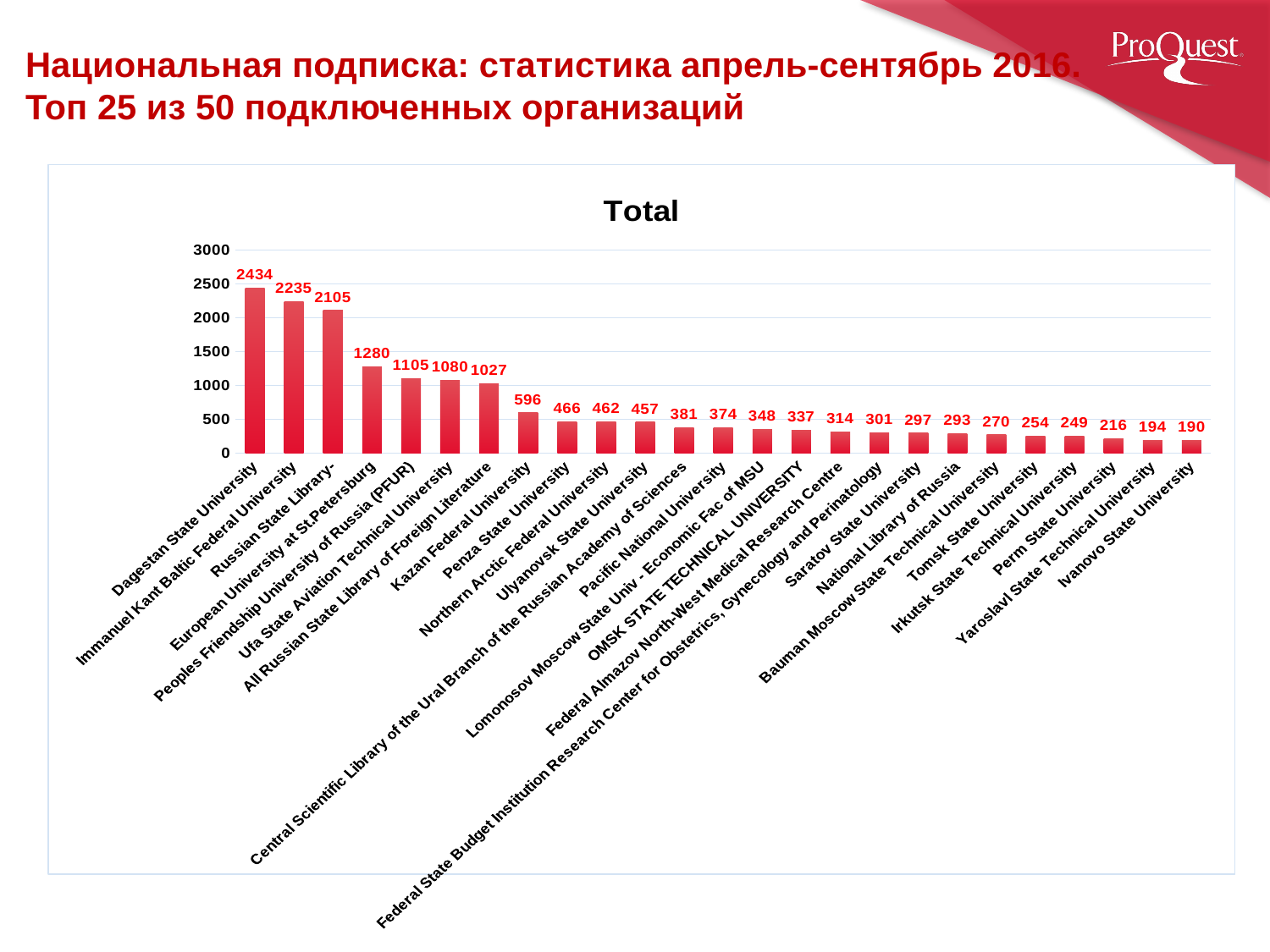
What is the value for Dagestan State University? 2434 What is the title of the chart? Total What kind of chart is shown on the slide? bar chart Which organization has the highest value? Dagestan State University What is the difference between the values for Dagestan State University and Immanuel Kant Baltic Federal University? 199 Which is larger, the value for Russian State Library or the value for European University at St.Petersburg? Russian State Library What is the value for Tomsk State University? 254 Is the value for Penza State University greater or less than 500? less Do the values rise or fall from left to right along the x axis? fall Which organization has the lowest value? Ivanovo State University What is the value for Kazan Federal University? 596 How many organizations are shown in the chart? 25